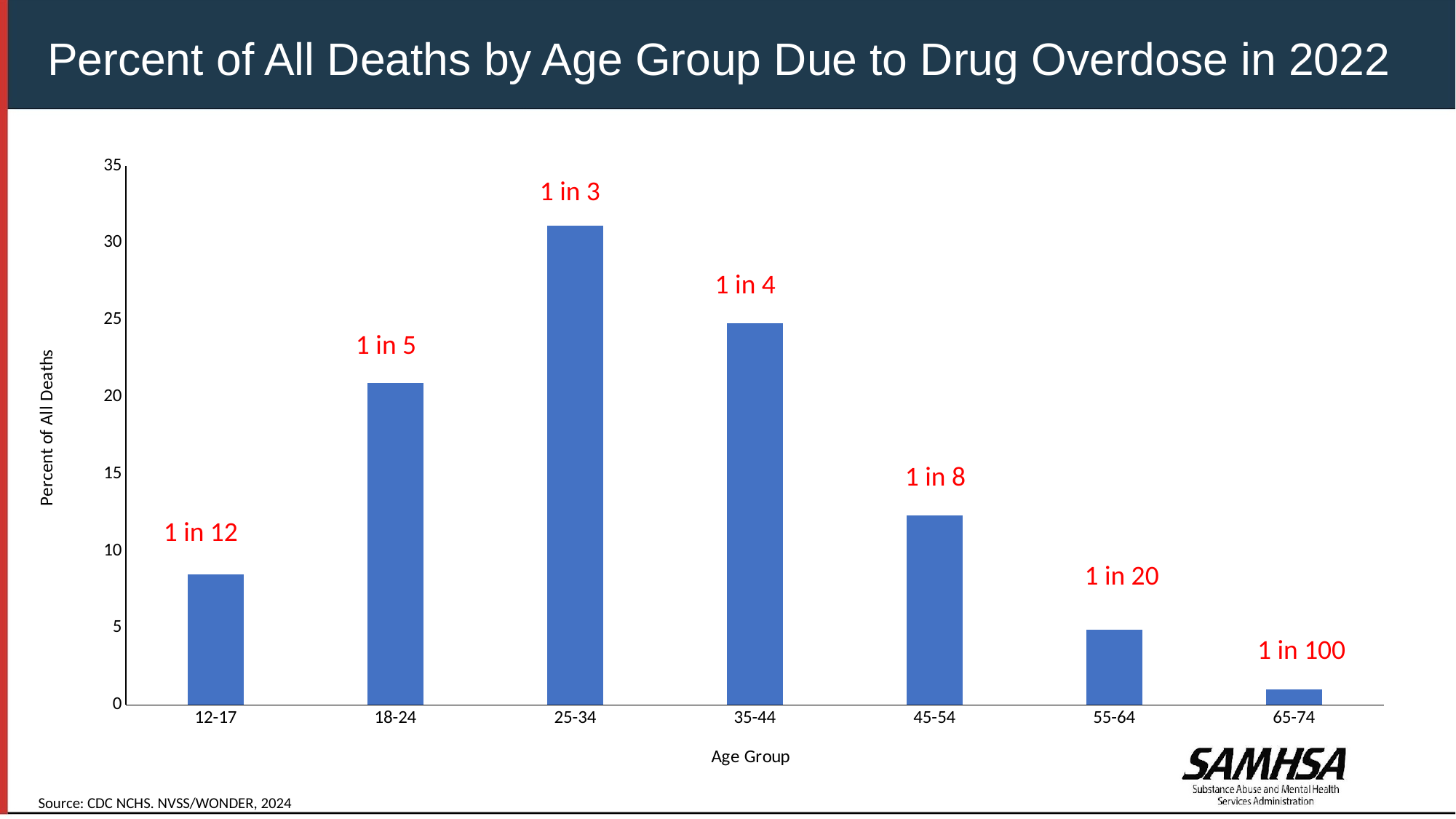
Is the value for the 25-34 age group greater or less than 30? greater What ratio label is printed above the bar for the 65-74 age group? 1 in 100 Which age group has the larger value, 18-24 or 45-54? 18-24 Which age group has the lowest percent of all deaths due to drug overdose? 65-74 Is the value for the 65-74 age group greater or less than 5? less What ratio label is printed above the bar for the 25-34 age group? 1 in 3 Which age group has the highest percent of all deaths due to drug overdose? 25-34 Is the value for the 45-54 age group greater or less than 10? greater Do the values rise or fall along the x axis from the 25-34 age group to the 65-74 age group? fall How many age groups are shown on the x axis? 7 What kind of chart is shown on the slide? bar chart